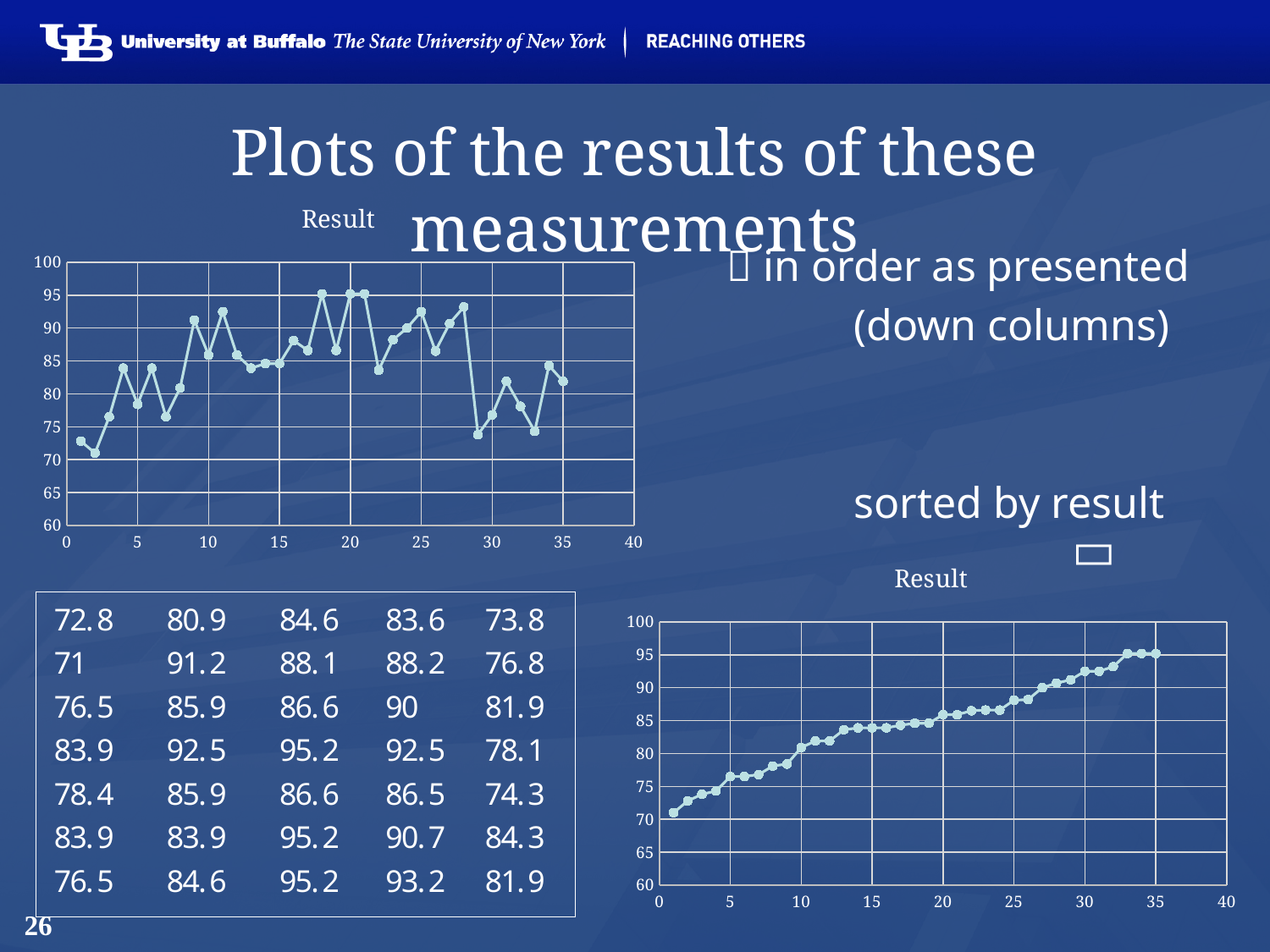
In the top-left chart (in order as presented), is the value at x = 18 greater or less than 90? greater In the top-left chart (in order as presented), is the value at x = 29 greater or less than 75? less In the top-left chart (in order as presented), is the value at x = 11 greater or less than 90? greater What type of chart is the top-left chart titled "Result"? line chart What type of chart is the bottom-right chart titled "Result"? line chart What is the highest value shown on the y axis of the top-left chart? 100 How many data points are plotted in the bottom-right chart (sorted by result)? 35 In the bottom-right chart (sorted by result), do the values rise or fall along the x axis? rise